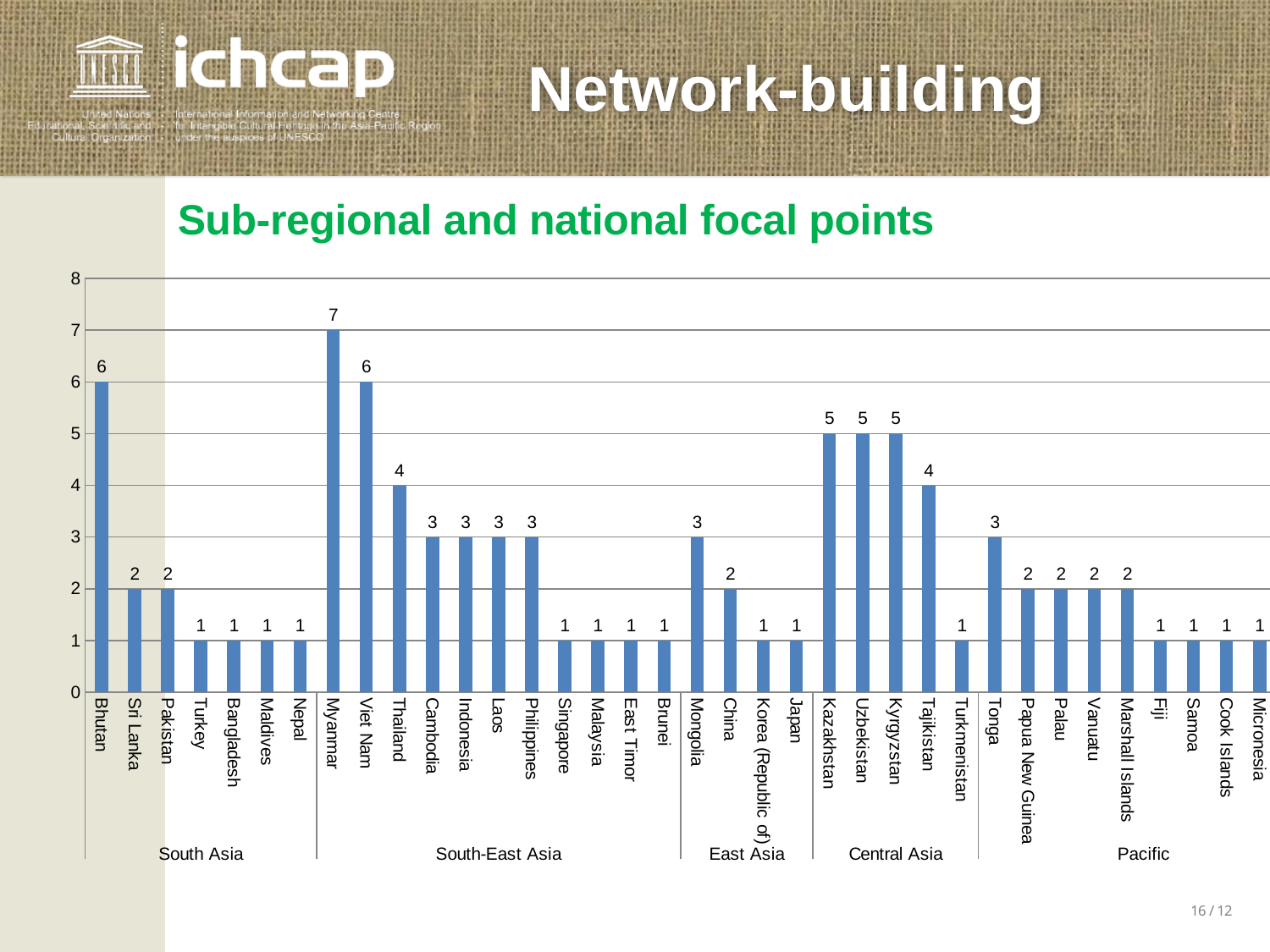
How many countries are shown on the x axis? 36 What is the value for Turkmenistan? 1 How many sub-regions are labelled along the x axis? 5 What kind of chart is shown? bar chart Which country has the highest value? Myanmar What is the difference between the values for Myanmar and Viet Nam? 1 What is the value for Kazakhstan? 5 What is the difference between the values for Bhutan and Sri Lanka? 4 What is the value for Bhutan? 6 Is the value for Myanmar greater or less than 5? greater Which has a larger value, Mongolia or China? Mongolia What is the value for Tonga? 3